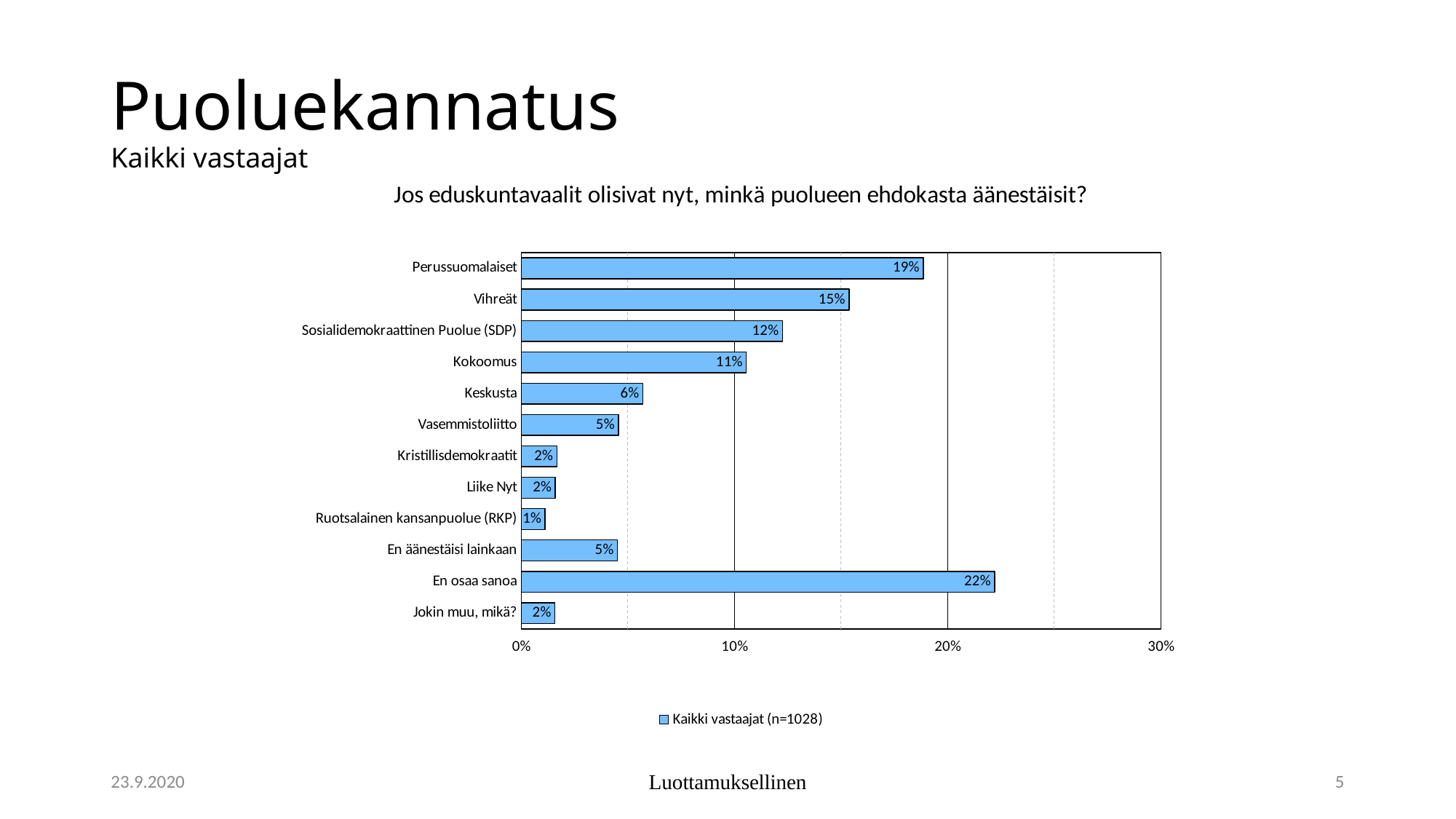
What is the value for Kokoomus? 11% What is the value for Vihreät? 15% What is the value for Ruotsalainen kansanpuolue (RKP)? 1% What is the value for Perussuomalaiset? 19% Which is larger, the value for Sosialidemokraattinen Puolue (SDP) or the value for Kokoomus? Sosialidemokraattinen Puolue (SDP) What is the difference between the values for Perussuomalaiset and Vihreät? 4% What kind of chart is shown on the slide? bar chart Which category has the highest value? En osaa sanoa Which category has the lowest value? Ruotsalainen kansanpuolue (RKP) Is the value for En osaa sanoa greater or less than 20%? greater What is the legend entry of the chart? Kaikki vastaajat (n=1028) How many categories are shown in the chart? 12